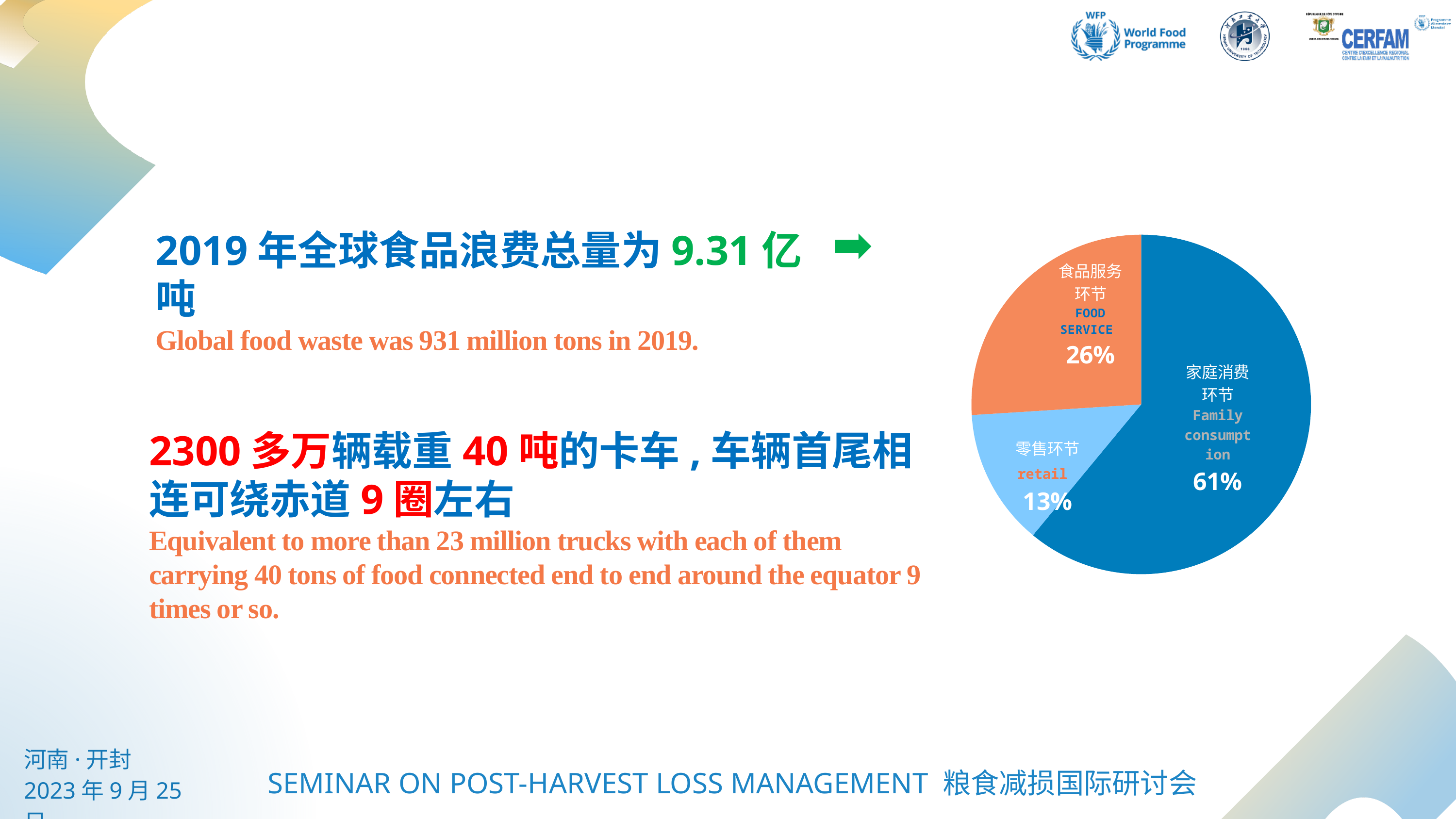
What share of the pie does Food service account for? 26% What is the difference in percentage points between Food service and retail? 13 What share of the pie does Family consumption account for? 61% Which slice of the pie chart is the largest? Family consumption What colour is the Family consumption slice? dark blue What is the difference in percentage points between Family consumption and Food service? 35 How many slices does the pie chart have? 3 What colour is the Food service slice? orange Which is larger, the Food service slice or the retail slice? Food service What share of the pie does retail account for? 13% Which slice of the pie chart is the smallest? retail What kind of chart is shown on the slide? pie chart